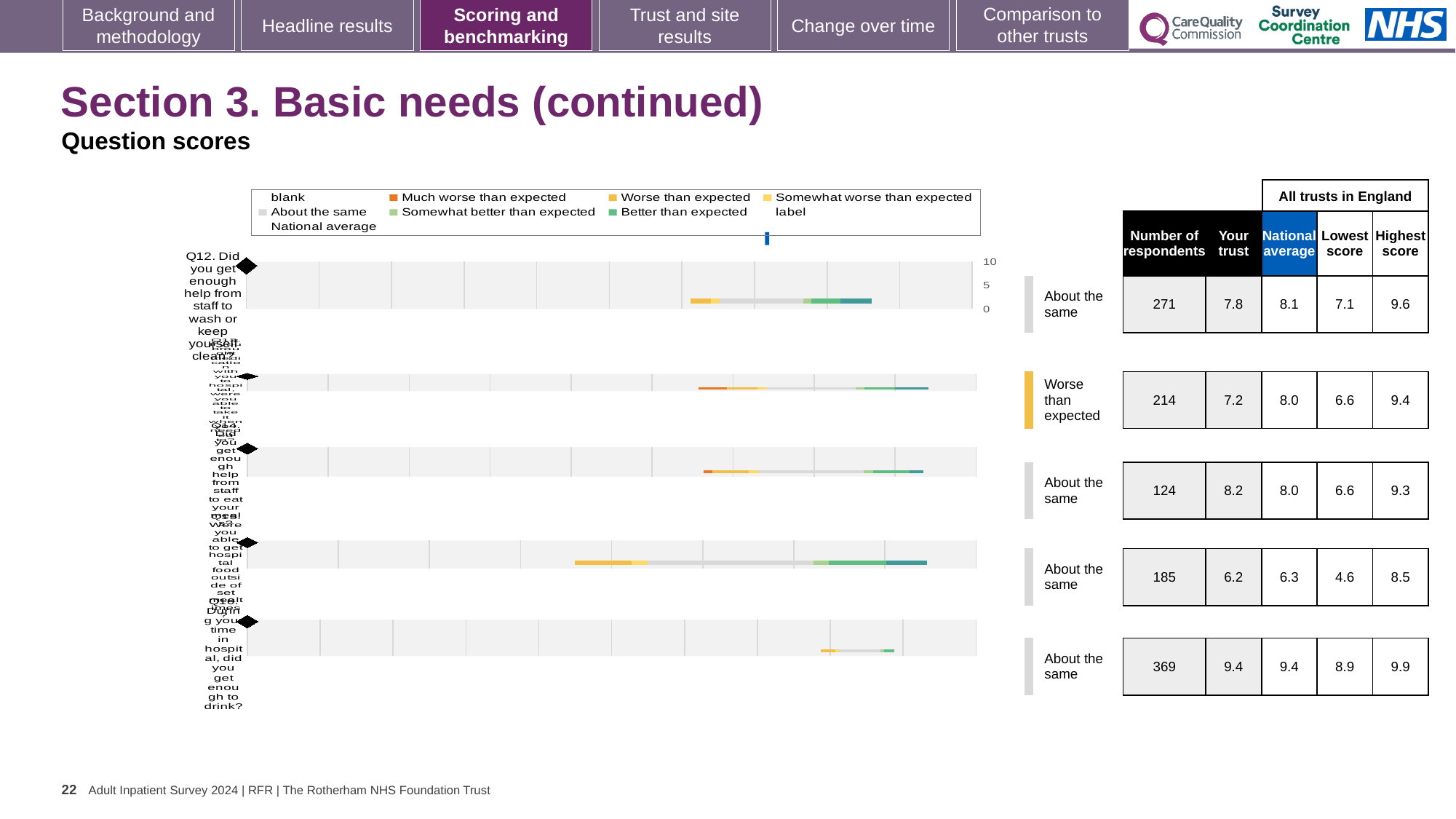
How many question rows (bars) does the chart show? 5 What colour does the legend use for 'Much worse than expected'? orange Which row has the lowest 'Your trust' score? the fourth row, 6.2 What benchmark category is given for the second row? Worse than expected How many respondents are listed for Q12 (help from staff to wash or keep yourself clean)? 271 For Q12, what is the difference between the highest score (9.6) and the lowest score (7.1) across all trusts in England? 2.5 Is the 'Your trust' marker for Q12 greater or less than 5 on the axis? greater For the second row, which is larger: the 'Your trust' score or the national average? national average (8.0) What is the national average score for Q12 (help from staff to wash or keep yourself clean)? 8.1 Which row has the highest 'Your trust' score? the fifth (bottom) row, 9.4 What is the 'Your trust' score for Q12 (help from staff to wash or keep yourself clean)? 7.8 What kind of chart is shown on the slide? bar chart